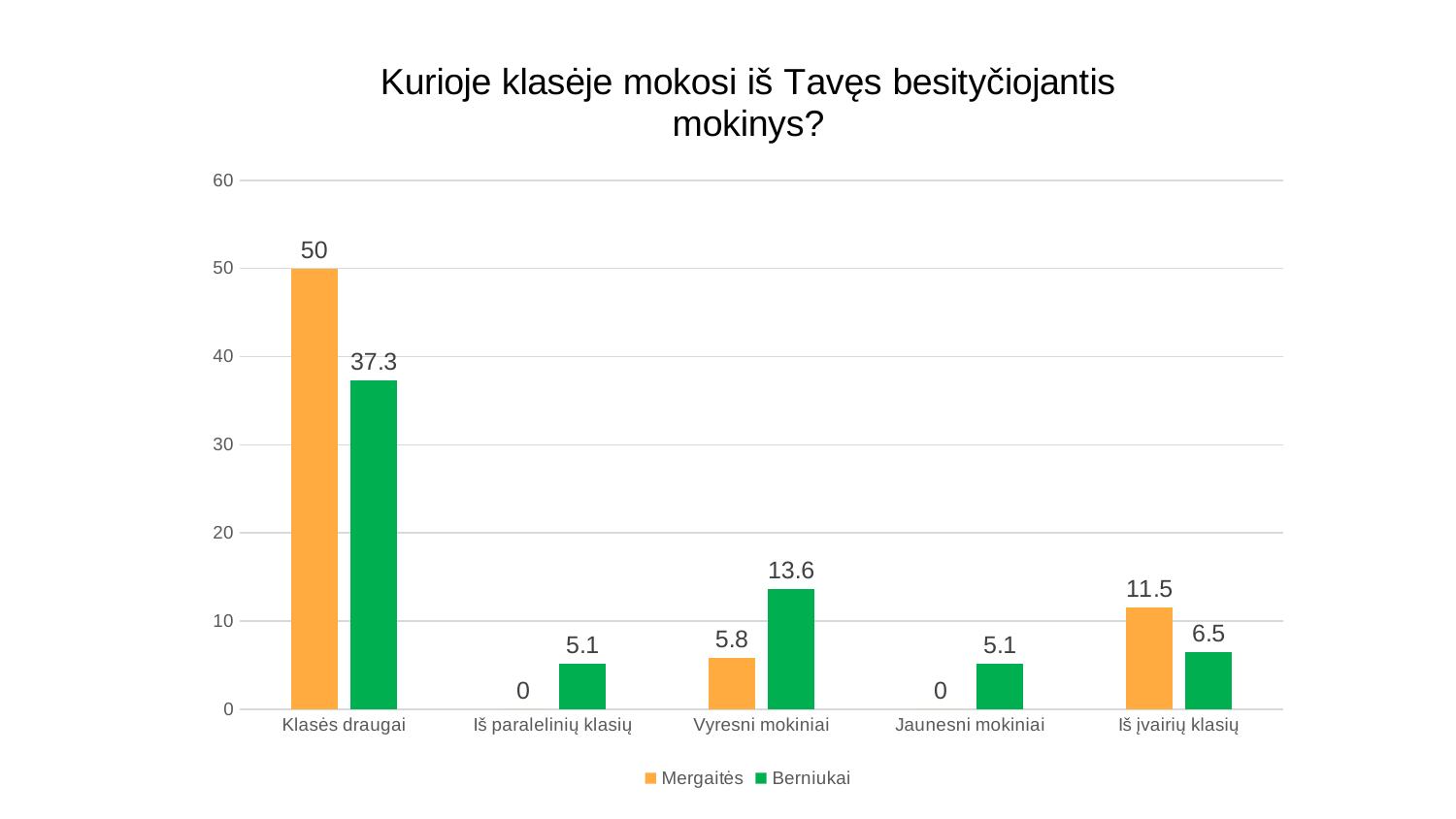
Which category has the lowest value for Berniukai? Iš paralelinių klasių and Jaunesni mokiniai (both 5.1) Which colour represents the Berniukai series? green What is the value for Mergaitės in the Iš įvairių klasių category? 11.5 What is the difference between the Mergaitės and Berniukai values for Klasės draugai? 12.7 Which category has the highest value for Berniukai? Klasės draugai Which is larger in the Vyresni mokiniai category, Mergaitės or Berniukai? Berniukai What is the value for Mergaitės in the Klasės draugai category? 50 What is the value for Berniukai in the Vyresni mokiniai category? 13.6 How many categories are shown on the x axis? 5 What kind of chart is shown on the slide? bar chart How many series does the legend list? 2 Is the value for Berniukai in Klasės draugai greater or less than 40? less